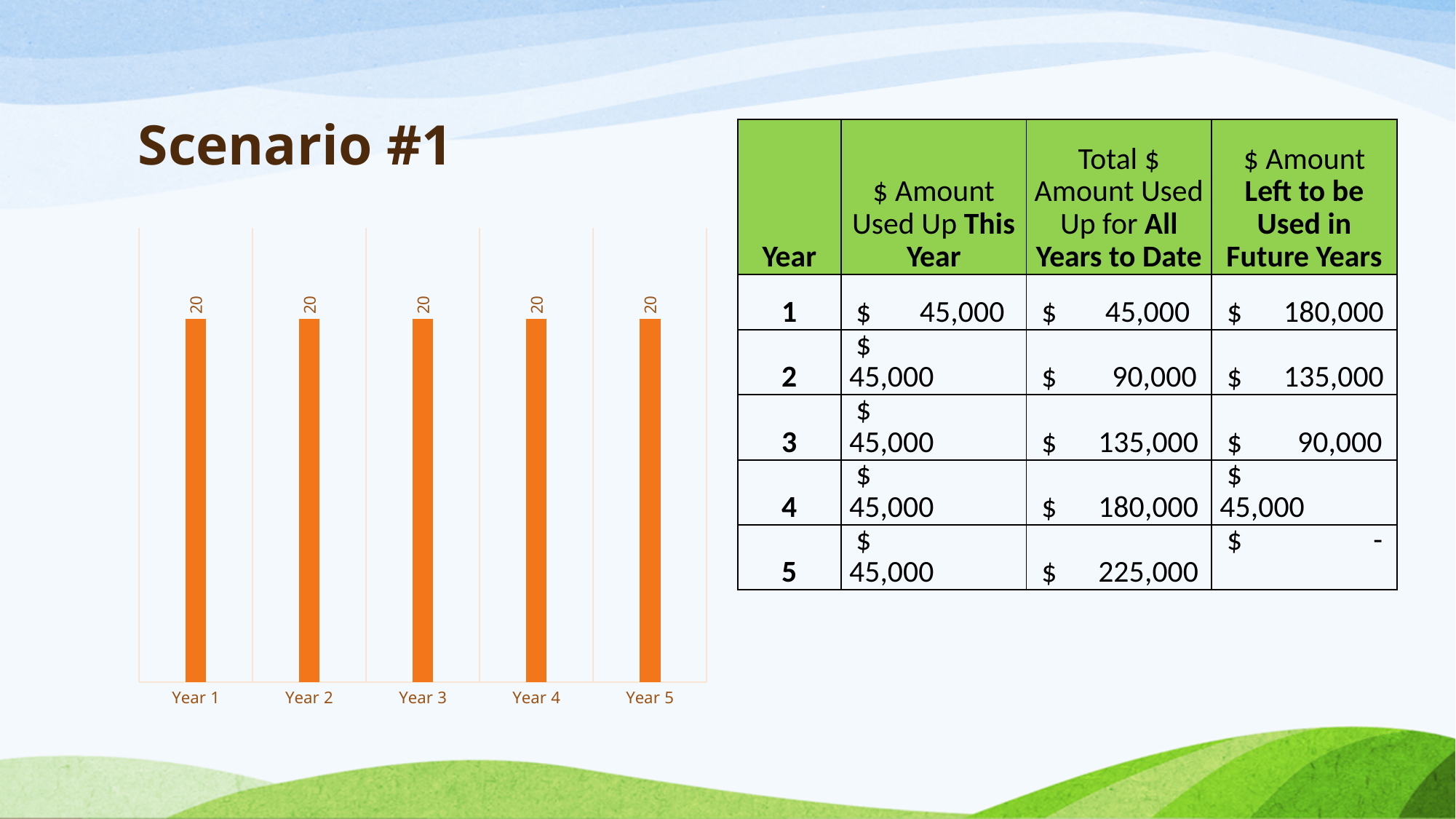
Do the bar values rise, fall, or stay the same from Year 1 to Year 5? Stay the same What is the data label on the bar for Year 5? 20 How many bars are plotted in the chart? 5 What colour are the bars in the chart? Orange What type of chart is shown on the left of the slide? Bar chart What is the difference between the values for Year 2 and Year 4? 0 What is the label of the first category on the x axis? Year 1 What is the data label on the bar for Year 1? 20 Is the value for Year 1 larger than, smaller than, or equal to the value for Year 5? Equal What is the total of the values for Year 1 and Year 2 combined? 40 What is the data label on the bar for Year 3? 20